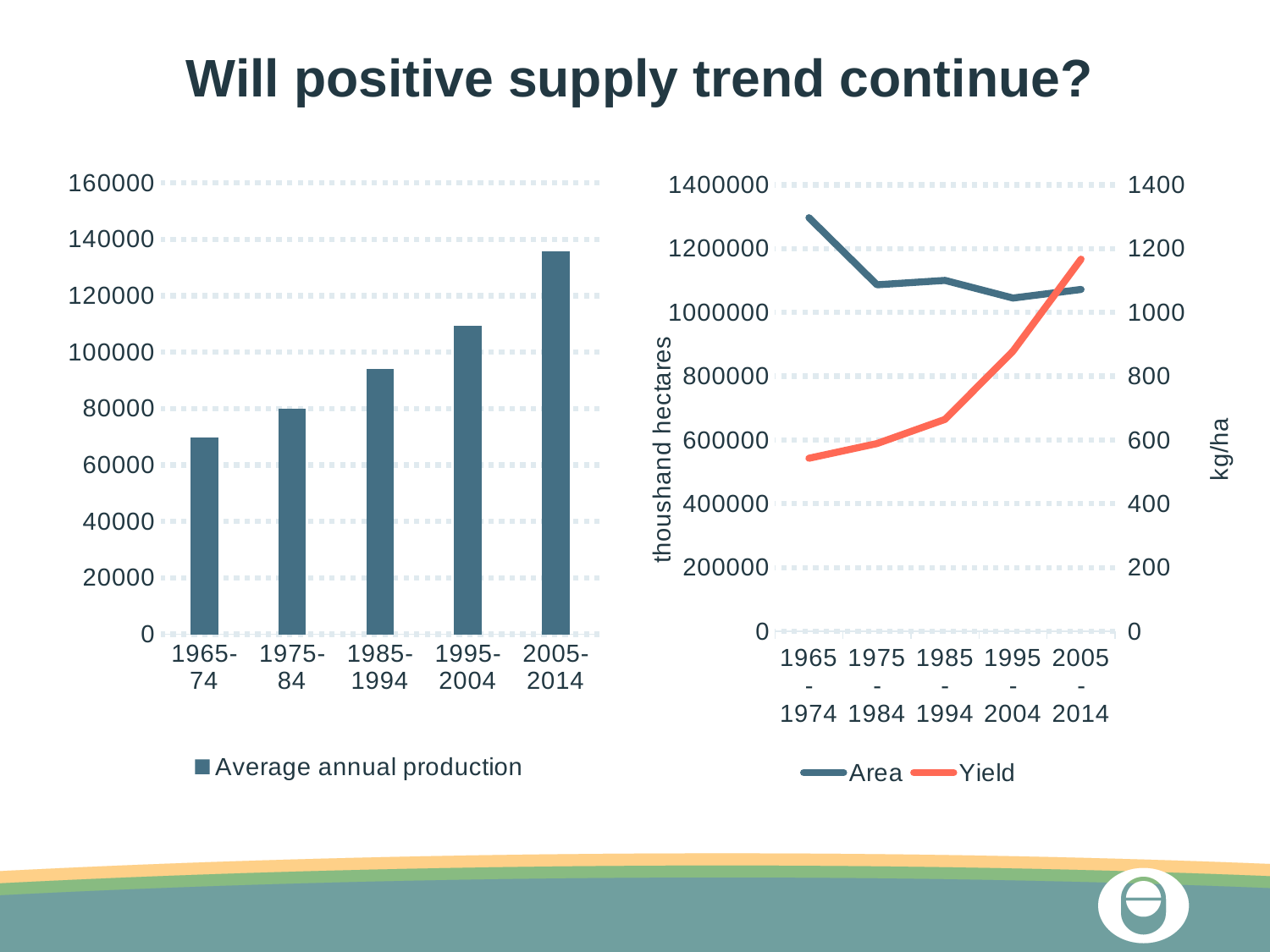
What kind of chart is the left chart (Average annual production)? bar chart What are the two series named in the legend of the right chart? Area and Yield In the left chart (Average annual production), which is larger: the value for 1985-1994 or the value for 1995-2004? 1995-2004 In the left chart (Average annual production), which period has the lowest value? 1965-74 In the left chart (Average annual production), do the values rise or fall from 1965-74 to 2005-2014? rise In the right chart, is the Area value for 1965-1974 greater or less than 1200000? greater In the left chart (Average annual production), is the value for 1965-74 greater or less than 80000? less In the left chart (Average annual production), which period has the highest value? 2005-2014 In the left chart (Average annual production), is the value for 2005-2014 greater or less than 120000? greater How many periods are shown on the x axis of the left chart (Average annual production)? 5 In the right chart, does the Yield series rise or fall from 1965-1974 to 2005-2014? rise How many series does the legend of the right chart list? 2